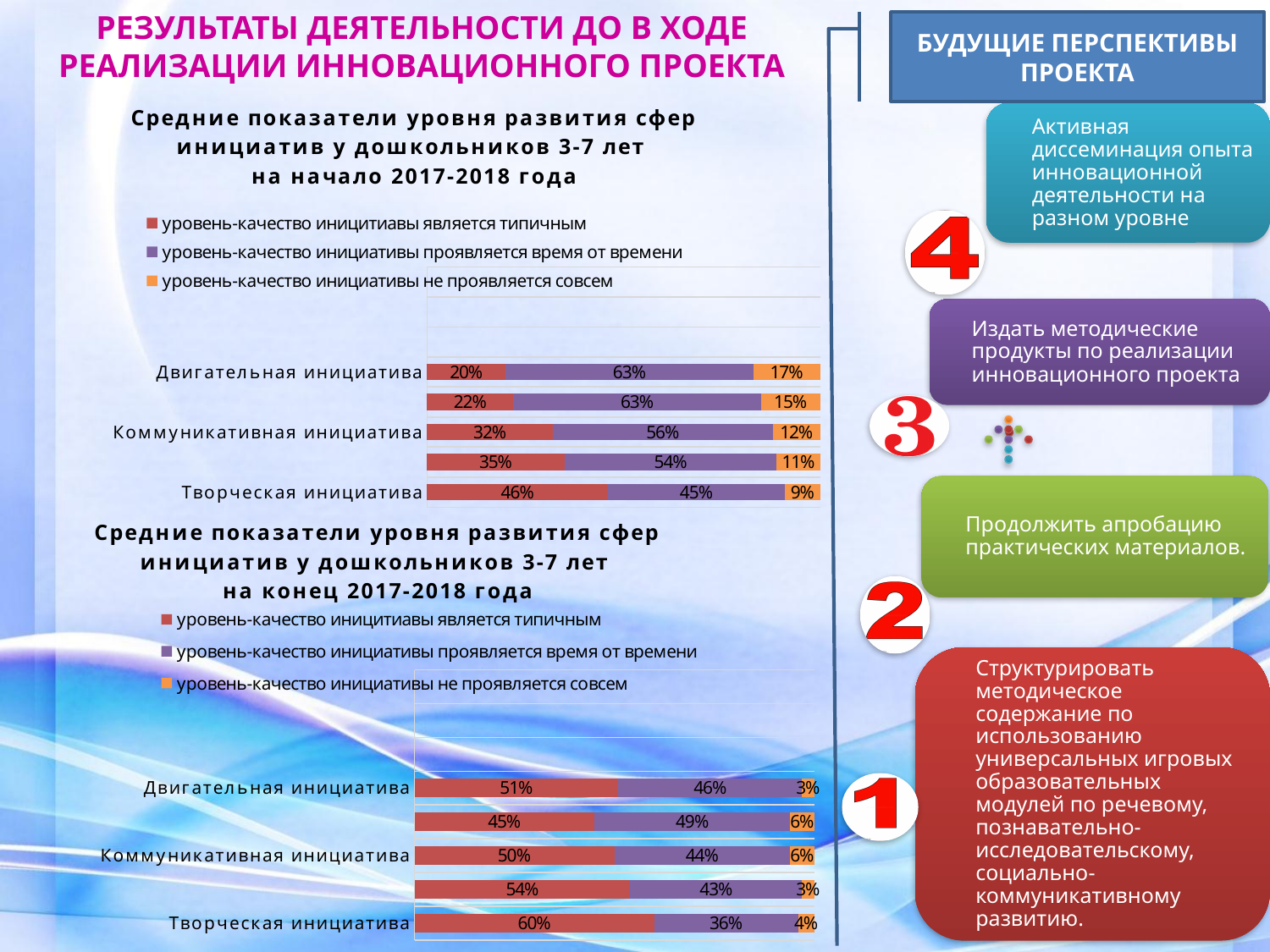
In the bottom chart, which is larger for Двигательная инициатива: 'является типичным' or 'проявляется время от времени'? является типичным How many series does the legend of the top chart list? 3 In the chart 'на конец 2017-2018 года' (bottom chart), what is the value of 'уровень-качество инициативы проявляется время от времени' for Коммуникативная инициатива? 44% In the chart 'на конец 2017-2018 года' (bottom chart), what is the value of 'уровень-качество инициативы является типичным' for Творческая инициатива? 60% In the bottom chart, which labeled category has the lowest value for 'уровень-качество инициативы проявляется время от времени'? Творческая инициатива In the top chart, which labeled category has the highest value for 'уровень-качество инициативы является типичным'? Творческая инициатива What kind of chart is the bottom chart 'на конец 2017-2018 года'? Stacked bar chart In the chart 'на начало 2017-2018 года' (top chart), what is the value of 'уровень-качество инициативы не проявляется совсем' for Коммуникативная инициатива? 12% In the top chart, what is the difference between the 'является типичным' values for Творческая инициатива and Двигательная инициатива? 26% In the top chart, what is the total of the three segments for Коммуникативная инициатива? 100% In the chart 'на начало 2017-2018 года' (top chart), what is the value of 'уровень-качество инициативы проявляется время от времени' for Двигательная инициатива? 63% What colour represents 'уровень-качество инициативы не проявляется совсем' in the charts? Orange